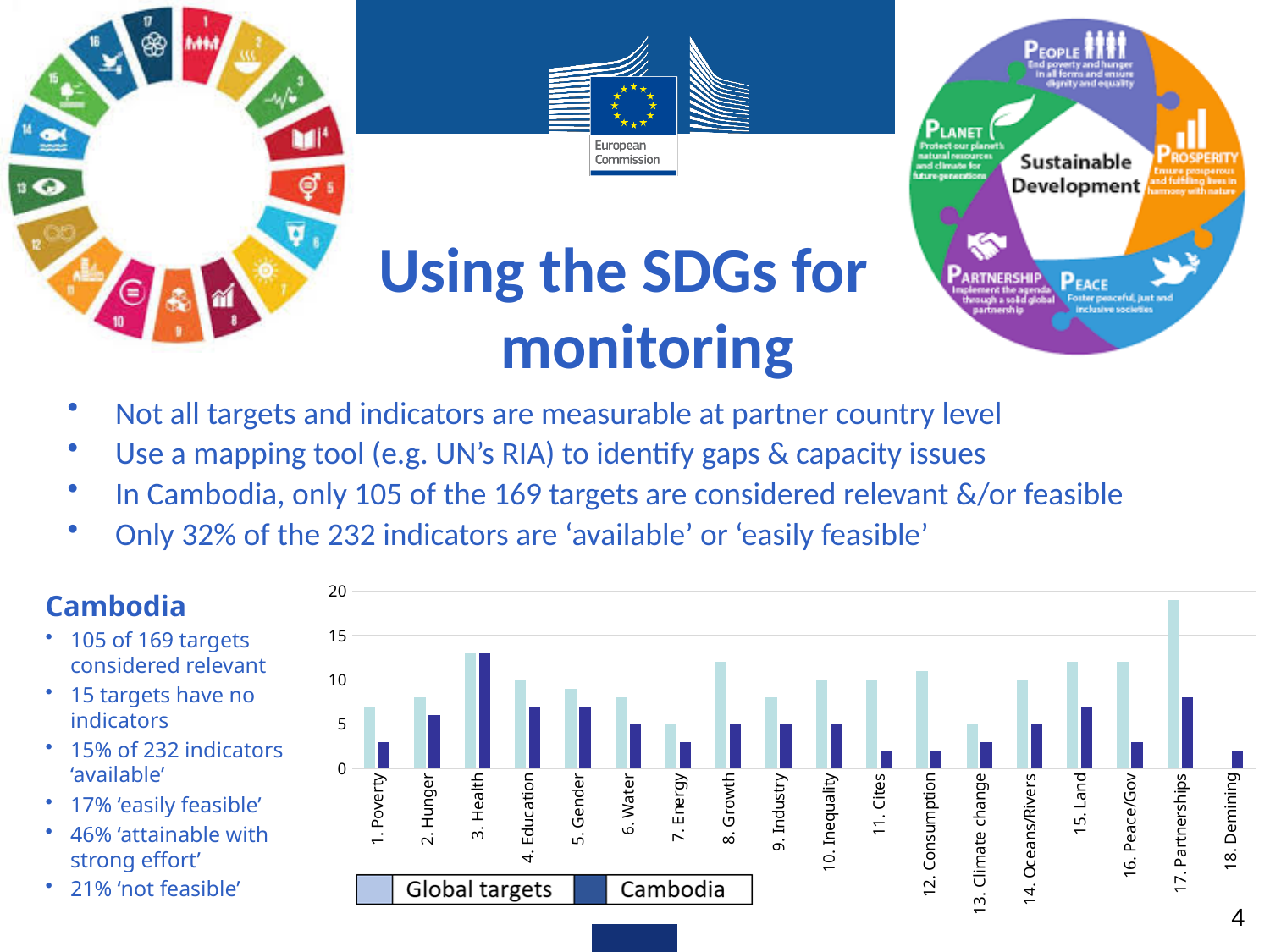
Is the Cambodia value for 3. Health greater or less than 10? greater For 17. Partnerships, which series has the larger value, Global targets or Cambodia? Global targets Is the Cambodia value for 11. Cites greater or less than 5? less Is the Global targets value for 8. Growth greater or less than 10? greater For 16. Peace/Gov, which series has the larger value, Global targets or Cambodia? Global targets How many series does the chart's legend list? 2 How many categories are shown along the x axis of the chart? 18 What kind of chart is shown on the slide? bar chart Which category has the highest value for the Cambodia series? 3. Health Which category has the highest value for the Global targets series? 17. Partnerships What are the two series named in the chart's legend? Global targets and Cambodia